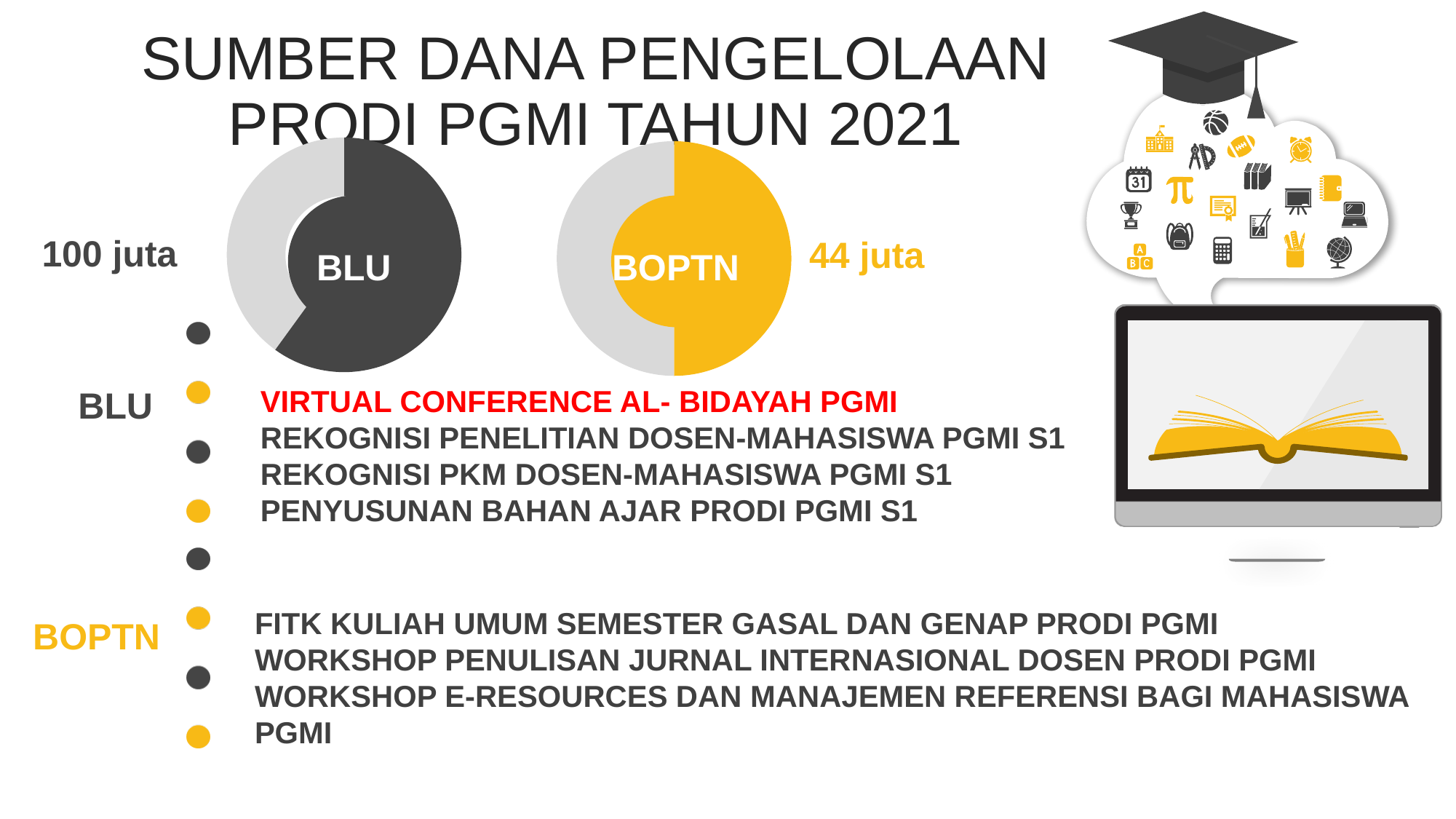
What label appears in the centre of the left doughnut chart? BLU What amount is shown next to the BOPTN doughnut chart? 44 juta Which funding source has the larger amount, BLU or BOPTN? BLU What is the difference between the BLU amount and the BOPTN amount? 56 juta What colour is the filled portion of the BOPTN doughnut chart? Yellow How many doughnut charts are shown on the slide? 2 What amount is shown next to the BLU doughnut chart? 100 juta What kind of chart is used to show the BLU and BOPTN funding sources? Doughnut (pie) chart Which funding source has the smaller amount shown on the slide? BOPTN